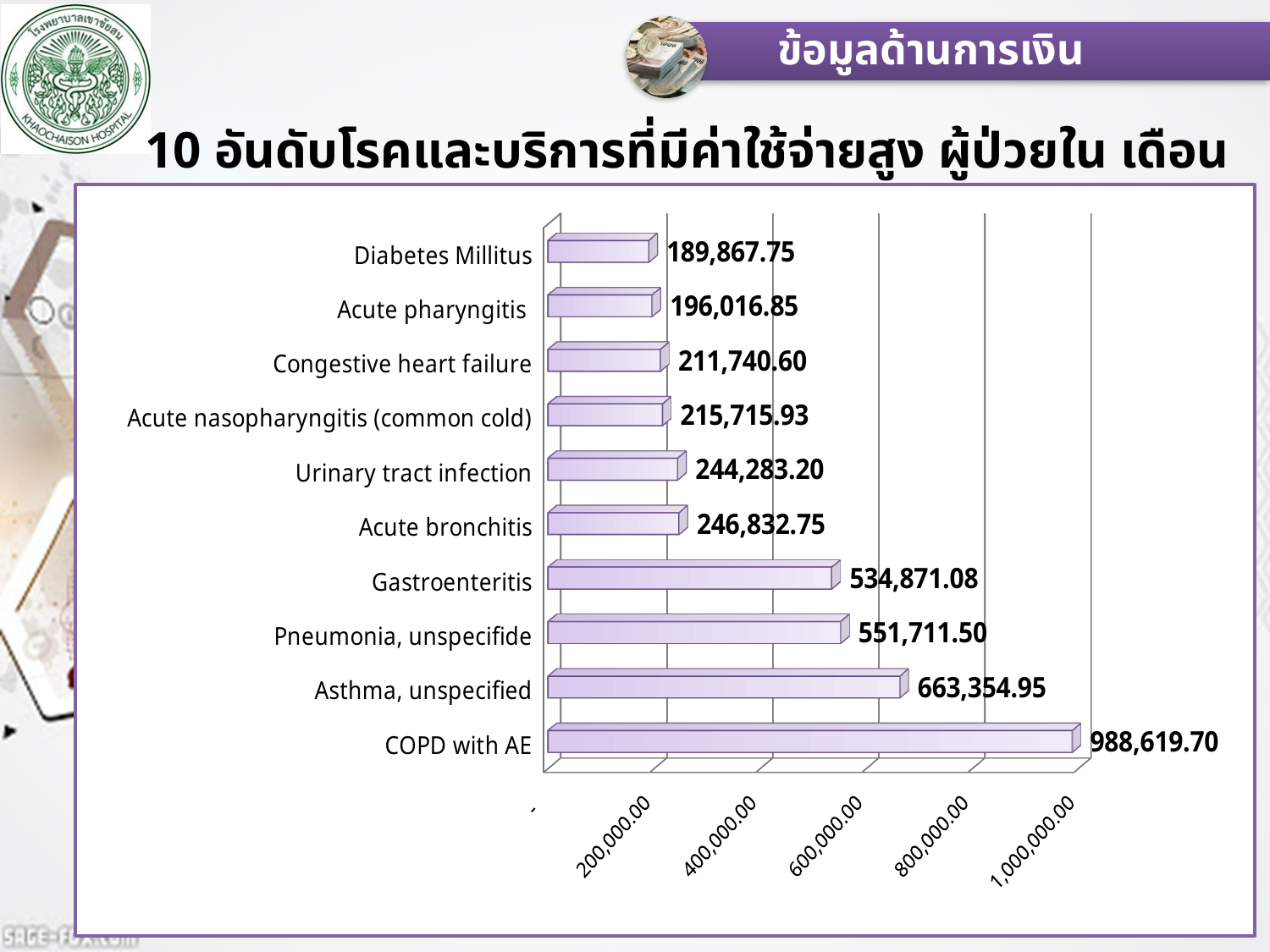
Which is larger, the value for Asthma, unspecified or the value for Pneumonia, unspecifide? Asthma, unspecified Is the value for COPD with AE greater or less than 800,000.00? greater What is the difference between the values for COPD with AE and Asthma, unspecified? 325,264.75 What kind of chart is shown on the slide? bar chart Which category has the lowest value? Diabetes Millitus How many categories are shown in the chart? 10 What is the difference between the values for Pneumonia, unspecifide and Gastroenteritis? 16,840.42 What is the value for Diabetes Millitus? 189,867.75 What is the value for Gastroenteritis? 534,871.08 What is the value for COPD with AE? 988,619.70 What is the value for Acute nasopharyngitis (common cold)? 215,715.93 Which category has the highest value? COPD with AE